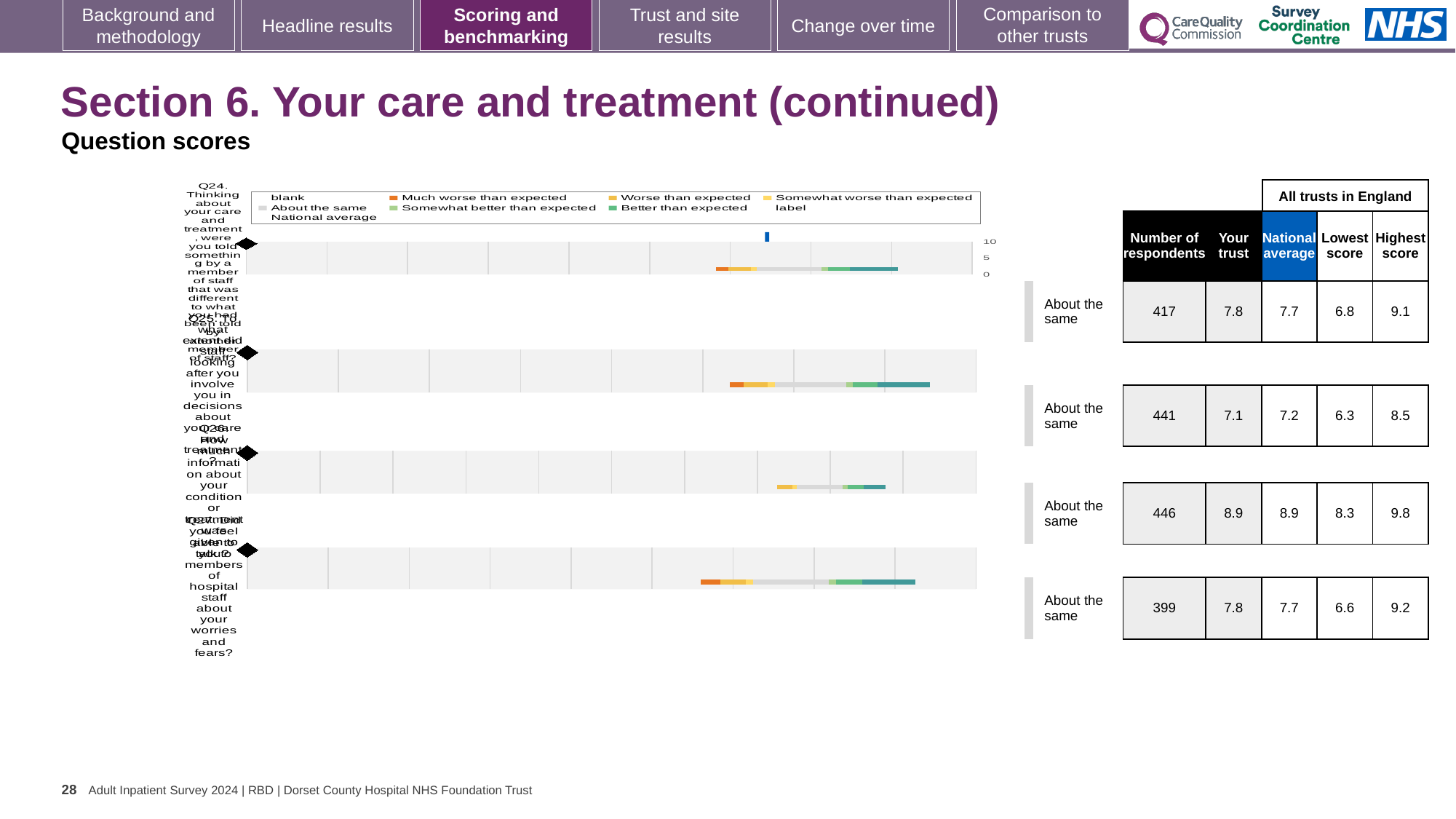
How many question charts (rows) are shown on the slide? 4 For the first chart row (Q24), what is the 'Your trust' score shown in the table? 7.8 How many entries does the legend above the charts list? 9 Which chart row has the lowest 'Your trust' score? the second row (Q25), 7.1 What benchmark category label is shown next to each of the four chart rows? About the same What kind of chart is used to show the question scores on this slide? bar chart Which chart row has the highest 'Your trust' score? the third row (Q26), 8.9 For the first chart row (Q24), what is the difference between the highest score (9.1) and the lowest score (6.8)? 2.3 For the fourth chart row (Q27), what is the highest score among all trusts in England? 9.2 For the second chart row (Q25), which is larger: the 'Your trust' score or the national average? National average For the third chart row (Q26), how many respondents are listed? 446 For the second chart row (Q25), what is the national average score? 7.2